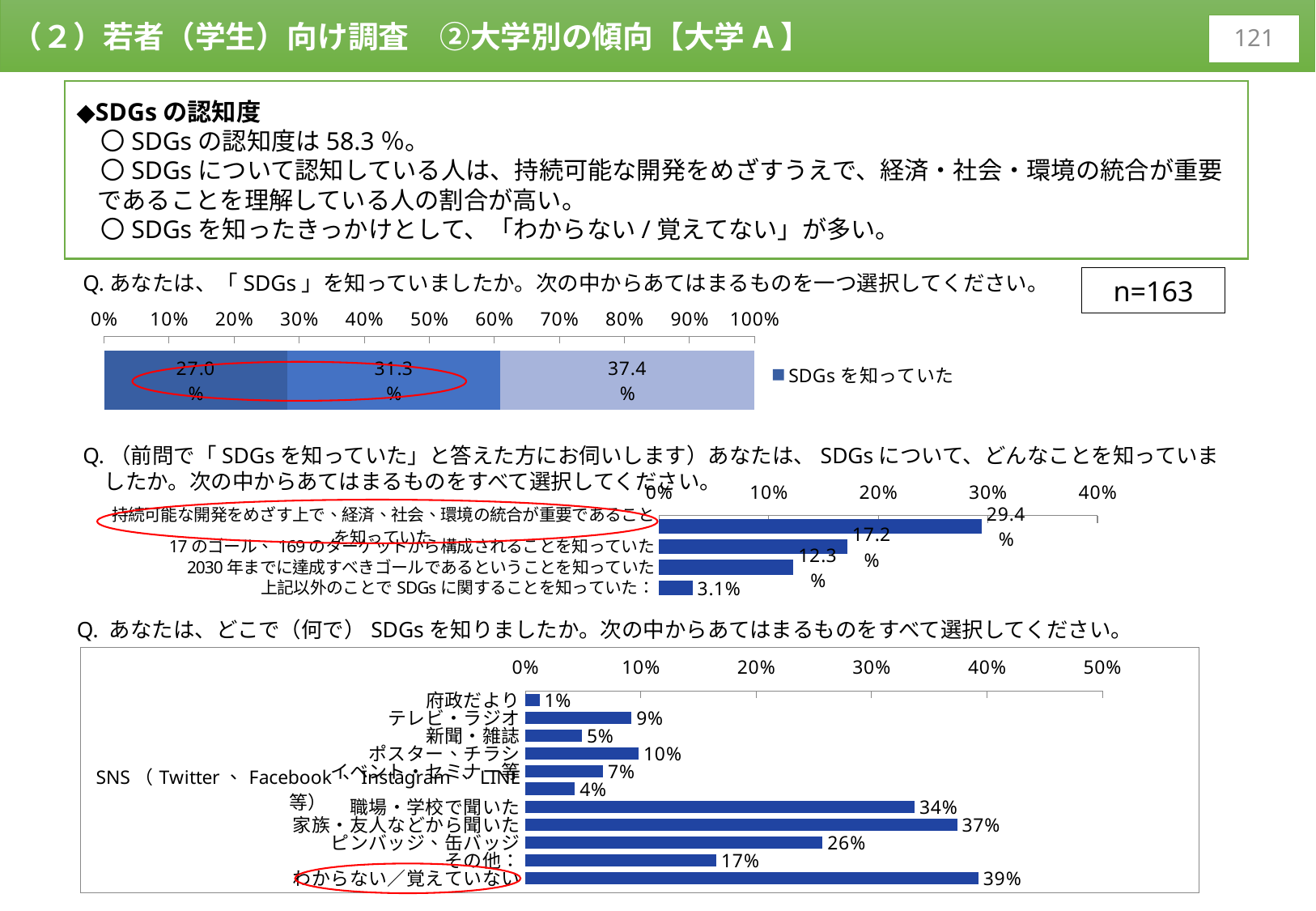
In the top stacked bar chart (SDGs awareness), what is the value of the lightest segment on the right? 37.4% In the bottom bar chart (where respondents learned about SDGs), what is the value for 「家族・友人などから聞いた」? 37% In the middle bar chart (what respondents knew about SDGs), which category has the highest value? 持続可能な開発をめざす上で、経済、社会、環境の統合が重要であることを知っていた In the bottom bar chart (where respondents learned about SDGs), what is the difference between 「わからない／覚えていない」 and 「その他」? 22% In the middle bar chart (what respondents knew about SDGs), how many categories are shown? 4 In the bottom bar chart (where respondents learned about SDGs), which category has the lowest value? 府政だより In the bottom bar chart (where respondents learned about SDGs), which category has the highest value? わからない／覚えていない In the top stacked bar chart (SDGs awareness), what is the difference between the 37.4% segment and the 27.0% segment? 10.4% In the top stacked bar chart (SDGs awareness), what is the value of the first (darkest) segment? 27.0% In the bottom bar chart (where respondents learned about SDGs), which is larger: 「職場・学校で聞いた」 or 「ピンバッジ、缶バッジ」? 職場・学校で聞いた In the middle bar chart (what respondents knew about SDGs), what is the value for 「上記以外のことでSDGsに関することを知っていた」? 3.1% What type of chart is the bottom chart (where respondents learned about SDGs)? Bar chart